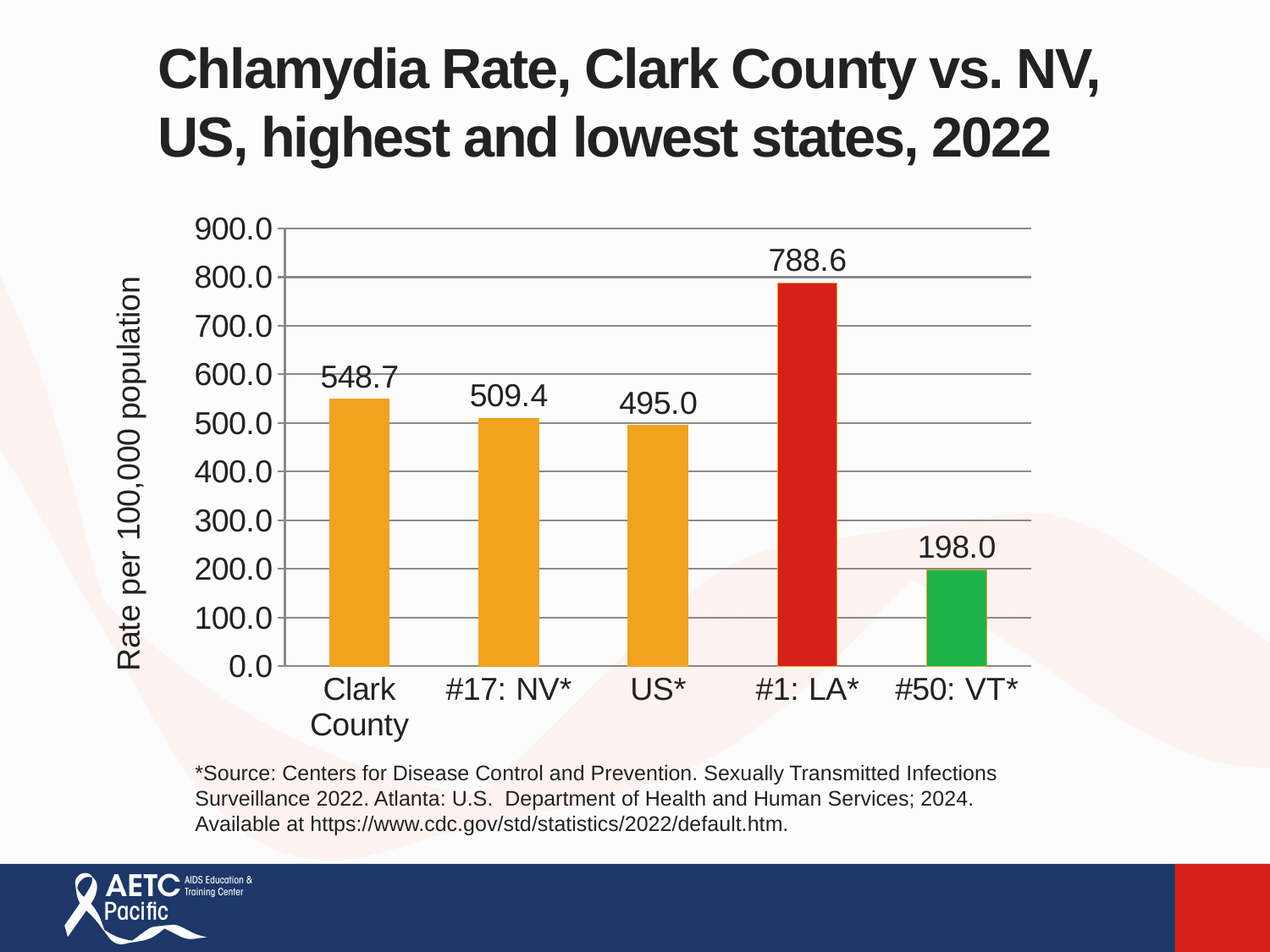
What is the chlamydia rate for #50: VT*? 198.0 What is the chlamydia rate for #17: NV*? 509.4 How many categories are shown on the chart? 5 What is the difference between the chlamydia rate for #1: LA* and for Clark County? 239.9 What kind of chart is shown on the slide? Bar chart What is the difference between the chlamydia rate for Clark County and for US*? 53.7 What is the label of the vertical axis? Rate per 100,000 population What is the chlamydia rate for Clark County? 548.7 What is the chlamydia rate for US*? 495.0 Which category has the lowest chlamydia rate? #50: VT* Which has a higher chlamydia rate, Clark County or #17: NV*? Clark County Which category has the highest chlamydia rate? #1: LA*